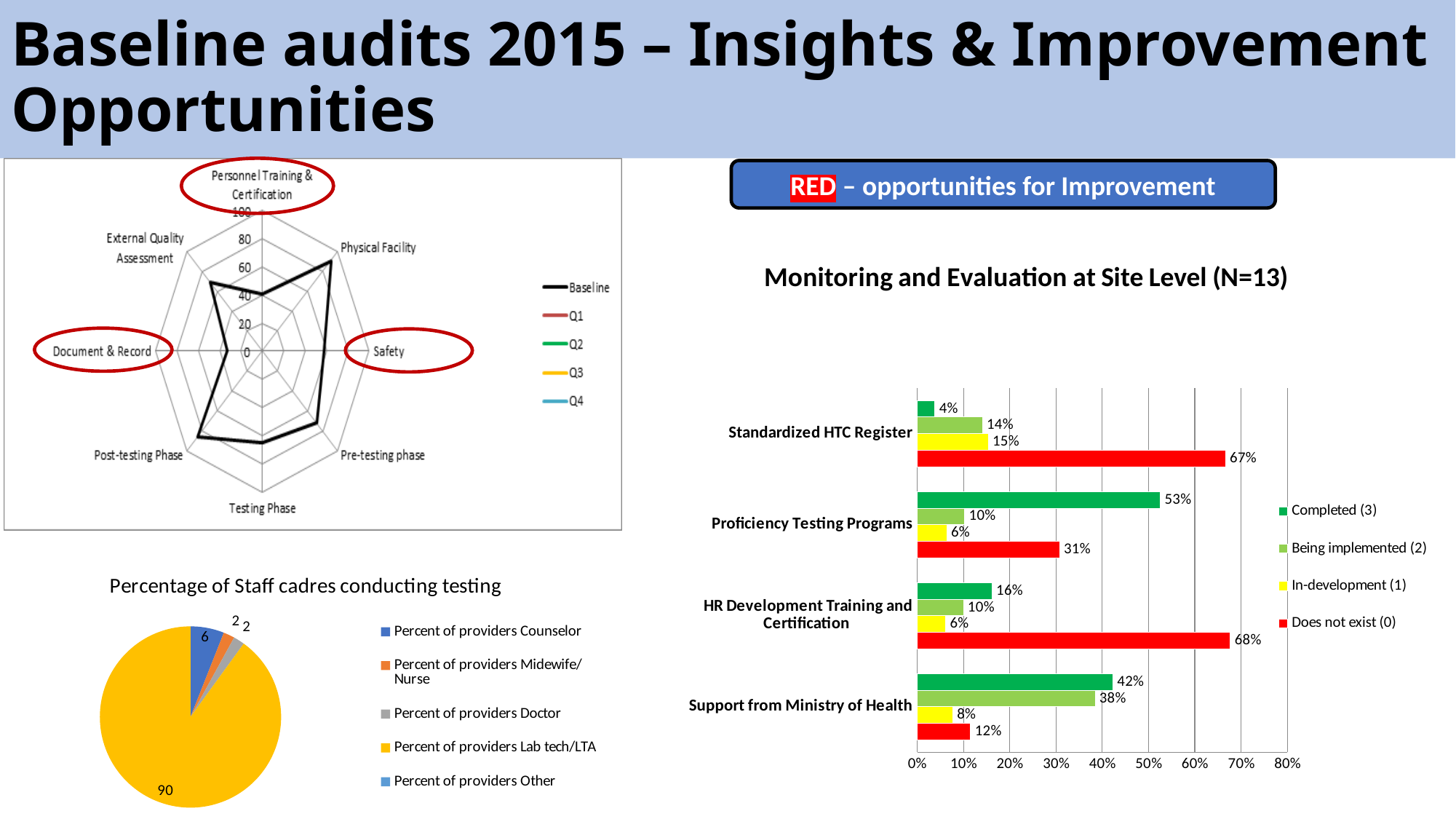
In the Percentage of Staff cadres conducting testing pie chart, what is the value for Percent of providers Counselor? 6 How many series does the legend of the Monitoring and Evaluation at Site Level chart list? 4 How many categories does the radar chart in the top left have? 8 In the Monitoring and Evaluation at Site Level chart, which category has the highest 'Does not exist (0)' value? HR Development Training and Certification In the Percentage of Staff cadres conducting testing pie chart, what is the value for Percent of providers Lab tech/LTA? 90 In the Monitoring and Evaluation at Site Level chart, what is the difference between the 'Completed (3)' and 'Being implemented (2)' values for Support from Ministry of Health? 4% How many series does the legend of the radar chart in the top left list? 5 What kind of chart is the Monitoring and Evaluation at Site Level chart? bar chart In the Monitoring and Evaluation at Site Level chart, what is the 'Completed (3)' value for Proficiency Testing Programs? 53% In the Monitoring and Evaluation at Site Level chart, is the 'Does not exist (0)' value for Proficiency Testing Programs larger or smaller than the 'Does not exist (0)' value for Support from Ministry of Health? larger In the Monitoring and Evaluation at Site Level chart, which category has the lowest 'Completed (3)' value? Standardized HTC Register In the Monitoring and Evaluation at Site Level chart, what is the 'Does not exist (0)' value for Standardized HTC Register? 67%